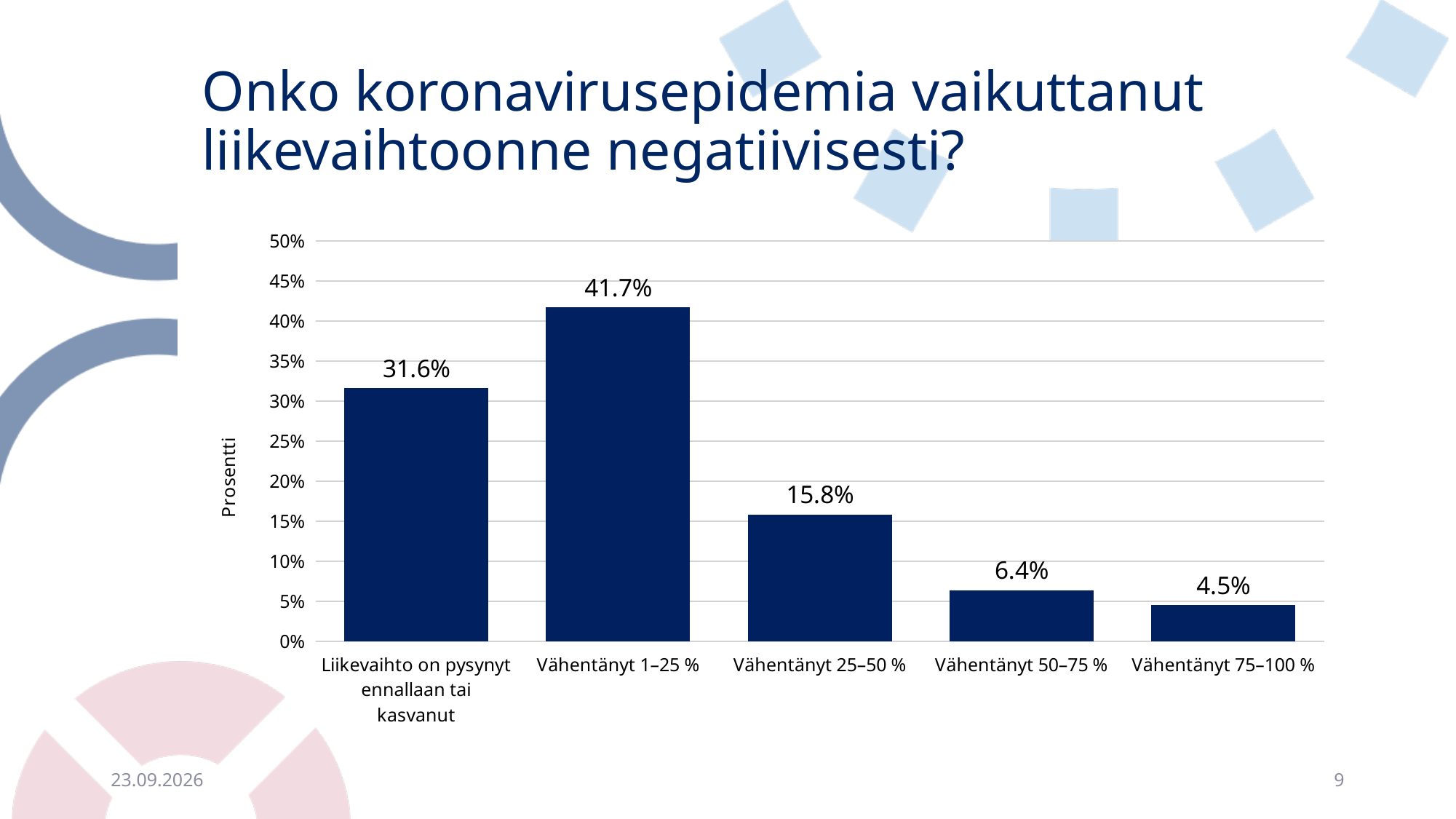
What is the difference between the values for "Vähentänyt 1–25 %" and "Liikevaihto on pysynyt ennallaan tai kasvanut"? 10.1% How many categories are shown in the chart? 5 Which is larger, the value for "Vähentänyt 25–50 %" or the value for "Vähentänyt 50–75 %"? Vähentänyt 25–50 % What is the value for "Liikevaihto on pysynyt ennallaan tai kasvanut"? 31.6% What is the value for "Vähentänyt 1–25 %"? 41.7% Is the value for "Vähentänyt 1–25 %" greater or less than 40%? greater What is the value for "Vähentänyt 75–100 %"? 4.5% What is the label of the vertical axis? Prosentti What kind of chart is shown on the slide? Bar chart Which category has the highest value? Vähentänyt 1–25 % Which category has the lowest value? Vähentänyt 75–100 % What is the difference between the values for "Vähentänyt 25–50 %" and "Vähentänyt 50–75 %"? 9.4%